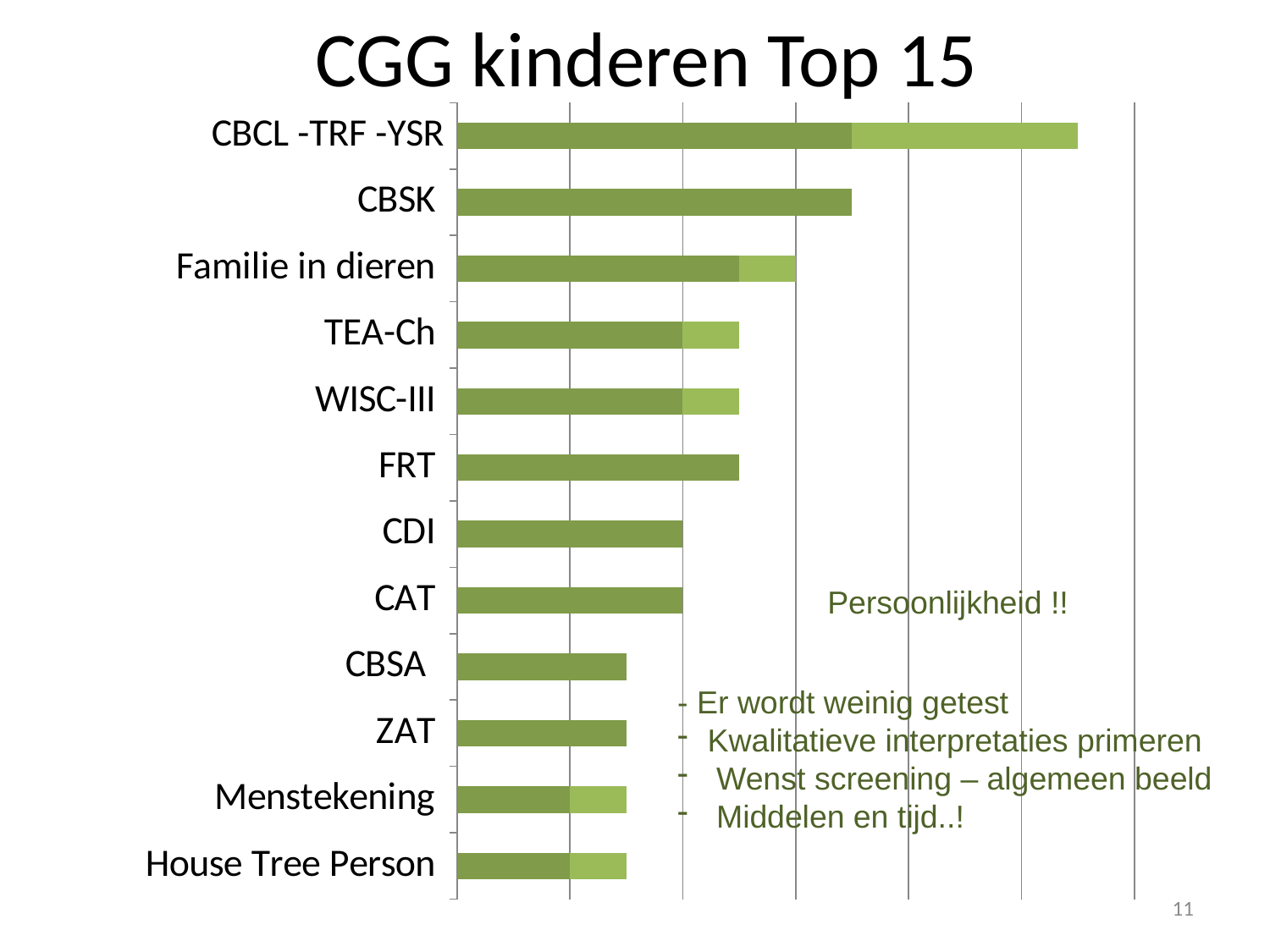
Which category is listed at the bottom of the chart? House Tree Person Which bar is longer, CBSK or Familie in dieren? CBSK What kind of chart is shown on the slide? bar chart Which bar is longer, Familie in dieren or TEA-Ch? Familie in dieren Which bar is longer, CBCL -TRF -YSR or CBSK? CBCL -TRF -YSR How many categories (tests) are plotted in the chart? 12 Do the bars generally get longer or shorter going from the top of the chart to the bottom? shorter What is the title of the chart? CGG kinderen Top 15 Which category has the longest bar in the chart? CBCL -TRF -YSR